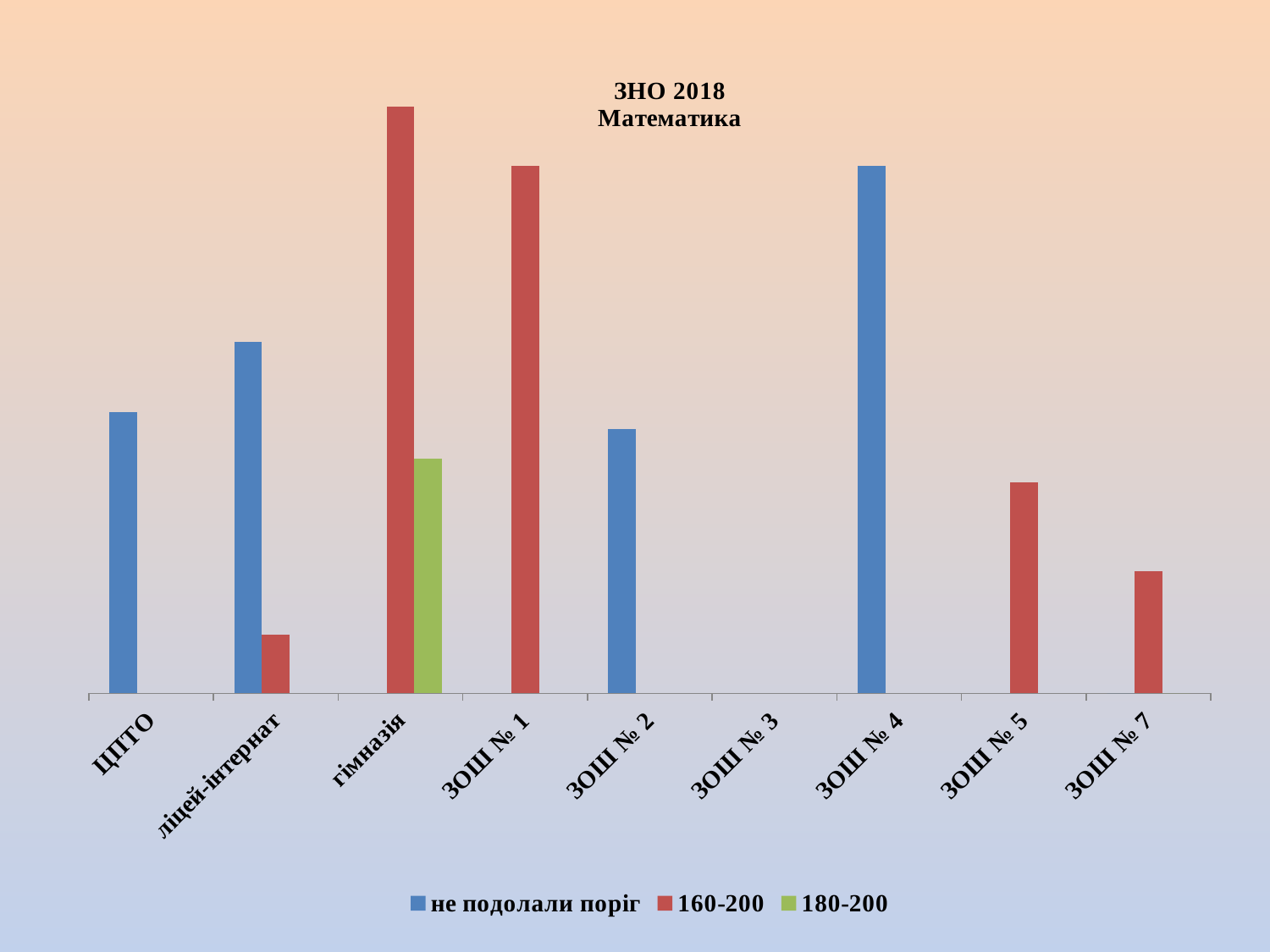
What is the title of the chart? ЗНО 2018 Математика What kind of chart is shown on the slide? bar chart For the series "не подолали поріг", which is larger: ЦПТО or ліцей-інтернат? ліцей-інтернат Which category has no bars at all? ЗОШ № 3 Which category has the lowest non-zero bar for the series "160-200"? ліцей-інтернат How many series does the legend list? 3 Which category has the highest bar for the series "не подолали поріг"? ЗОШ № 4 Which category is the only one with a bar for the series "180-200"? гімназія How many categories are shown on the x axis? 9 For the series "160-200", which is larger: гімназія or ЗОШ № 1? гімназія Which category has the highest bar for the series "160-200"? гімназія For the series "160-200", which is larger: ЗОШ № 5 or ЗОШ № 7? ЗОШ № 5